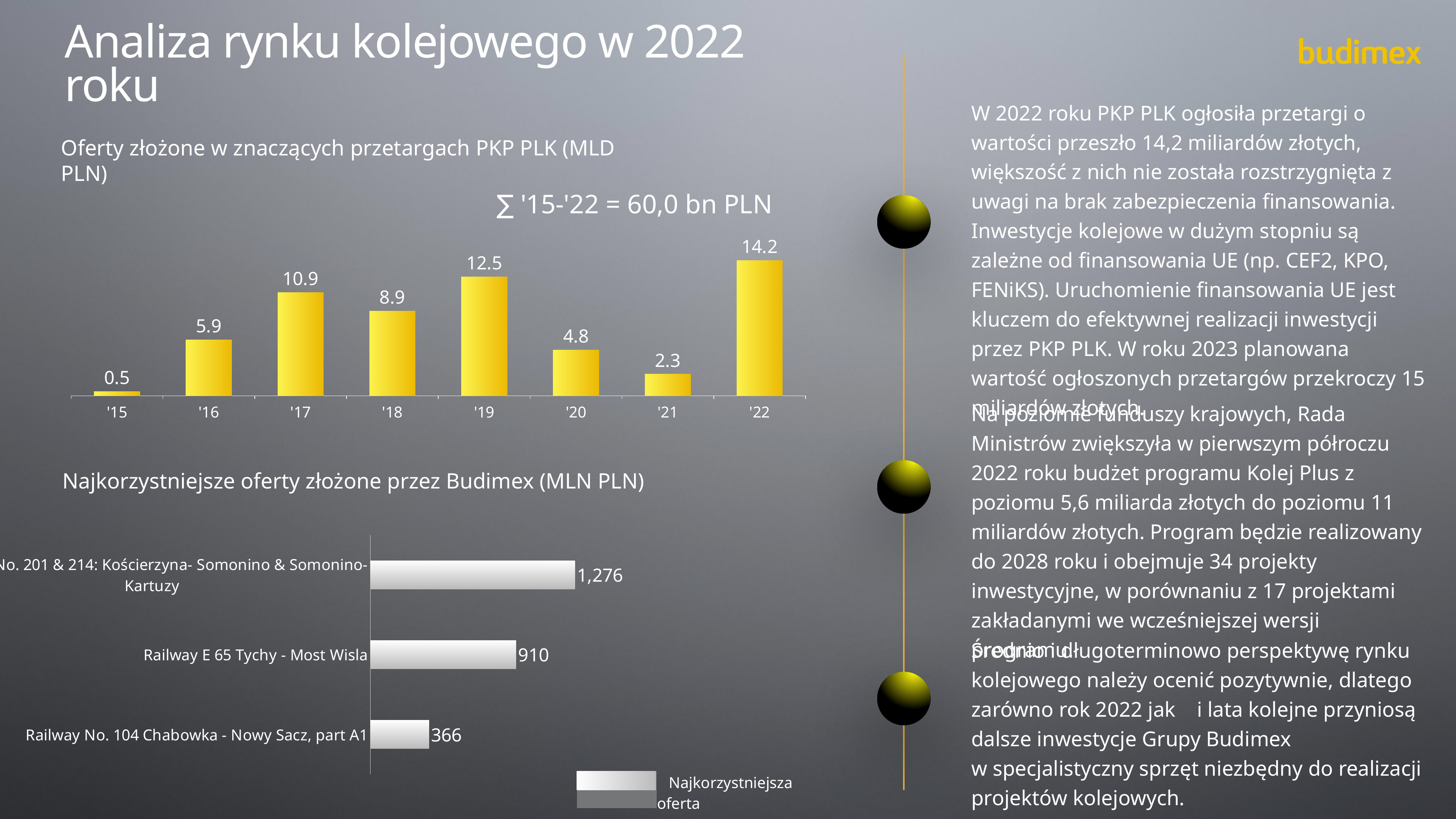
In the bottom chart 'Najkorzystniejsze oferty złożone przez Budimex (MLN PLN)', what is the value for 'Railway No. 104 Chabowka - Nowy Sacz, part A1'? 366 In the bottom chart 'Najkorzystniejsze oferty złożone przez Budimex (MLN PLN)', what is the difference between the largest and smallest values? 910 In the top chart 'Oferty złożone w znaczących przetargach PKP PLK (MLD PLN)', which year has the lowest value? '15 In the top chart 'Oferty złożone w znaczących przetargach PKP PLK (MLD PLN)', what is the value for '22? 14.2 In the top chart 'Oferty złożone w znaczących przetargach PKP PLK (MLD PLN)', which is larger, the value for '20 or the value for '21? '20 What type of chart is the top chart 'Oferty złożone w znaczących przetargach PKP PLK (MLD PLN)'? Bar chart In the bottom chart 'Najkorzystniejsze oferty złożone przez Budimex (MLN PLN)', what is the value for 'Railway E 65 Tychy - Most Wisla'? 910 In the top chart 'Oferty złożone w znaczących przetargach PKP PLK (MLD PLN)', what is the difference between the values for '17 and '18? 2.0 What legend entry is shown for the bottom chart 'Najkorzystniejsze oferty złożone przez Budimex (MLN PLN)'? Najkorzystniejsza oferta How many years are shown in the top chart 'Oferty złożone w znaczących przetargach PKP PLK (MLD PLN)'? 8 In the top chart 'Oferty złożone w znaczących przetargach PKP PLK (MLD PLN)', what is the value for '19? 12.5 In the top chart 'Oferty złożone w znaczących przetargach PKP PLK (MLD PLN)', which year has the highest value? '22